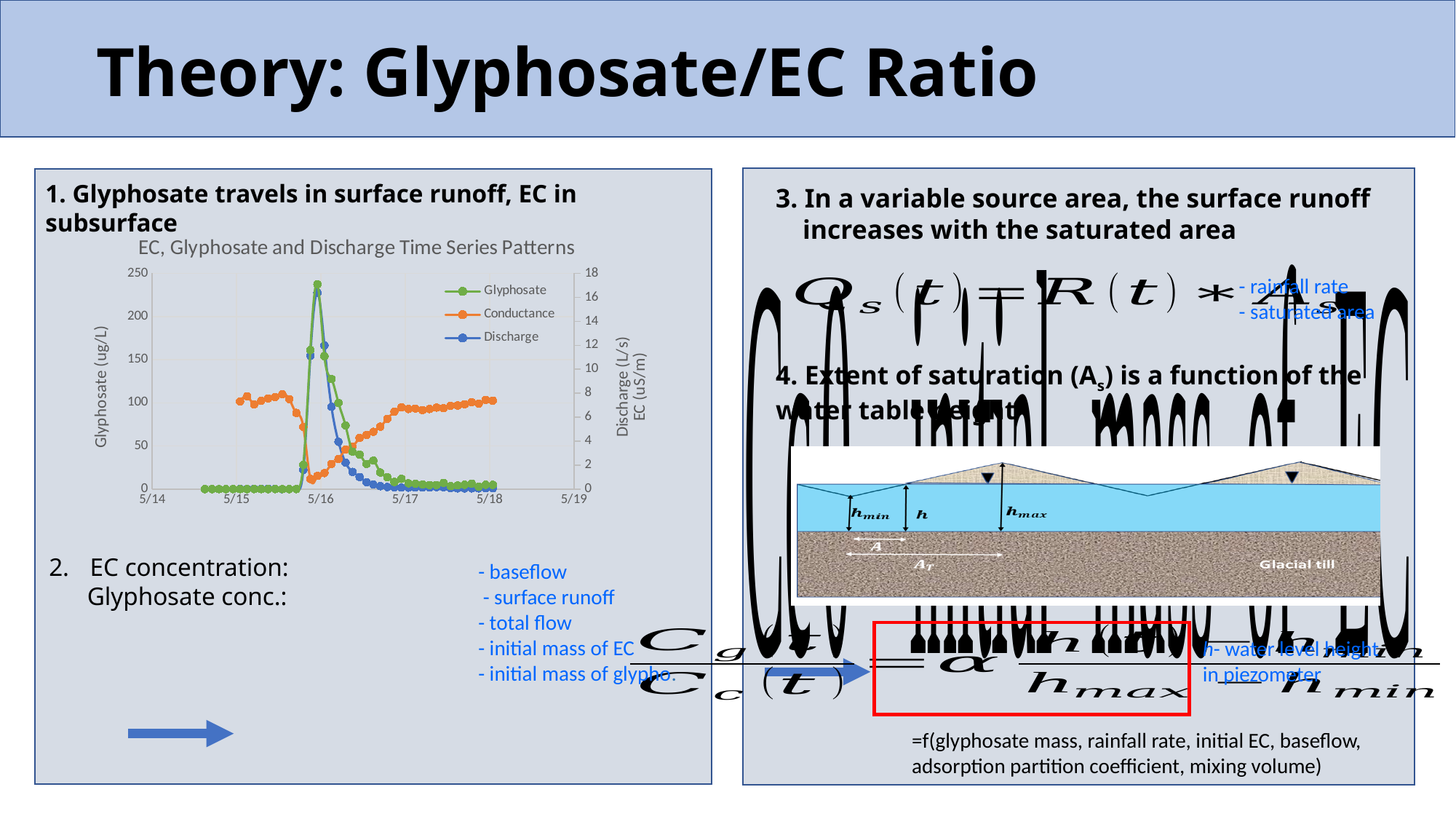
What is the maximum value shown on the left y axis of the chart? 250 What is the title of the chart? EC, Glyphosate and Discharge Time Series Patterns Does the Glyphosate series rise or fall between 5/16 and 5/17? fall Is the peak value of the Glyphosate series greater or less than 200 on the left axis? greater What kind of chart is shown on the slide? line chart Does the Conductance series rise or fall between 5/16 and 5/17? rise Is the Glyphosate value at 5/15 greater or less than 50 on the left axis? less How many series does the legend of the chart list? 3 How many date ticks are shown on the x axis of the chart? 6 Which series are listed in the chart's legend? Glyphosate, Conductance, Discharge Around 5/15, which series has the higher plotted value, Conductance or Glyphosate? Conductance Is the peak value of the Discharge series greater or less than 12 on the right axis? greater